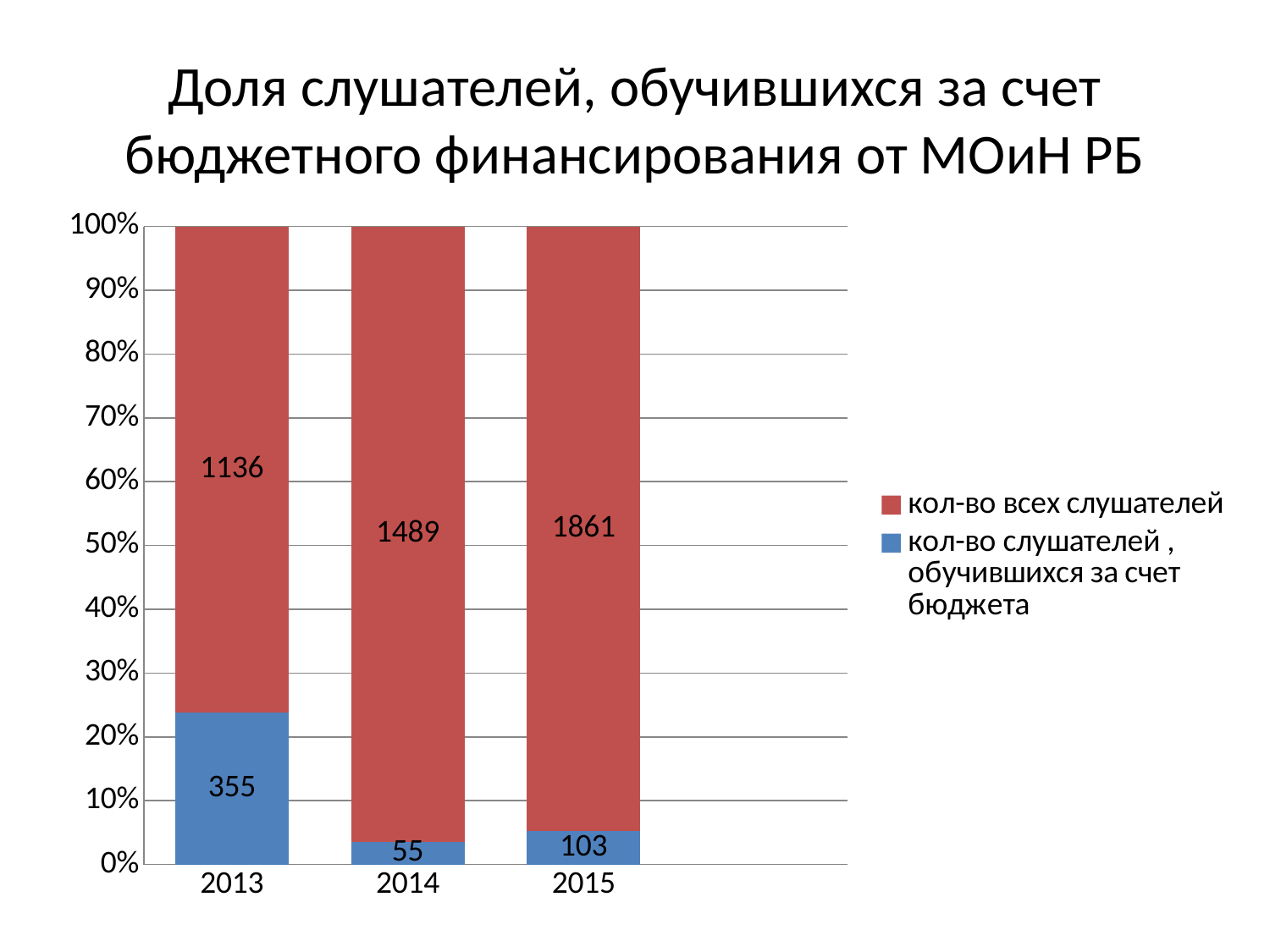
Is the share of the bar for 'кол-во слушателей, обучившихся за счет бюджета' in 2013 greater or less than 20%? greater What is the value labelled for 'кол-во всех слушателей' in 2013? 1136 Which is larger: the 'кол-во слушателей, обучившихся за счет бюджета' value for 2013 or for 2015? 2013 What is the value labelled for 'кол-во слушателей, обучившихся за счет бюджета' in 2014? 55 In which year is the labelled value for 'кол-во всех слушателей' the highest? 2015 How many series does the legend list? 2 What kind of chart is shown on the slide? stacked bar chart What is the value labelled for 'кол-во слушателей, обучившихся за счет бюджета' in 2015? 103 What is the value labelled for 'кол-во всех слушателей' in 2015? 1861 What is the difference between the 'кол-во всех слушателей' values for 2015 and 2014? 372 How many years are shown on the x axis? 3 In which year is the labelled value for 'кол-во слушателей, обучившихся за счет бюджета' the lowest? 2014